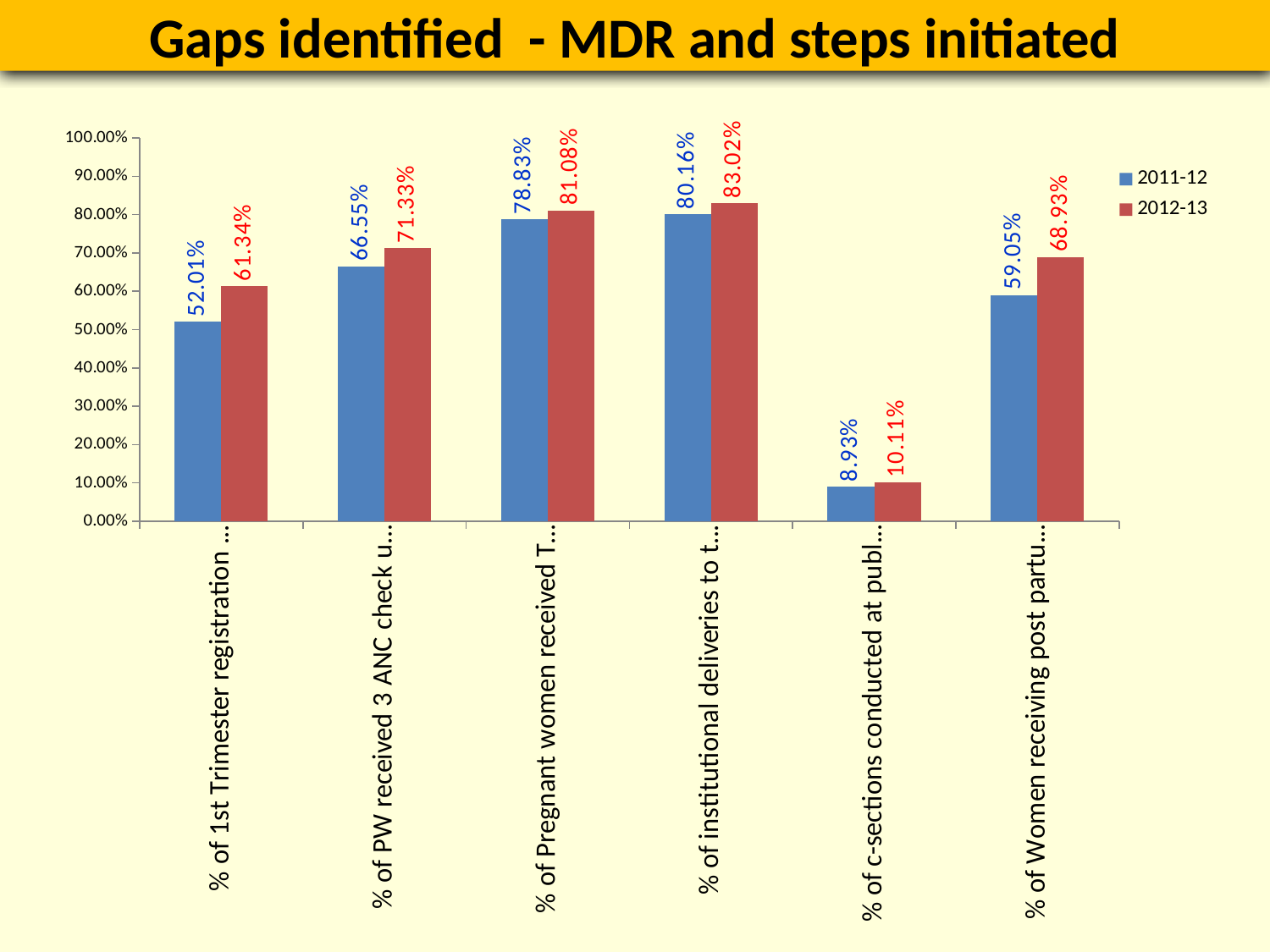
Which category has the highest 2012-13 value? % of institutional deliveries to t... How many categories are shown on the x axis? 6 What kind of chart is shown on the slide? Bar chart Which colour represents the 2012-13 series in the legend? Red How many series does the legend list? 2 What is the difference between the 2012-13 and 2011-12 values for the category beginning "% of 1st Trimester registration"? 9.33% What is the 2012-13 value for the category beginning "% of c-sections conducted at publ"? 10.11% For the category beginning "% of Pregnant women received T", which series has the larger value, 2011-12 or 2012-13? 2012-13 What is the 2011-12 value for the category beginning "% of PW received 3 ANC check u"? 66.55% Which category has the lowest 2011-12 value? % of c-sections conducted at publ... What is the 2012-13 value for the category beginning "% of Women receiving post partu"? 68.93% What is the 2011-12 value for the category beginning "% of 1st Trimester registration"? 52.01%